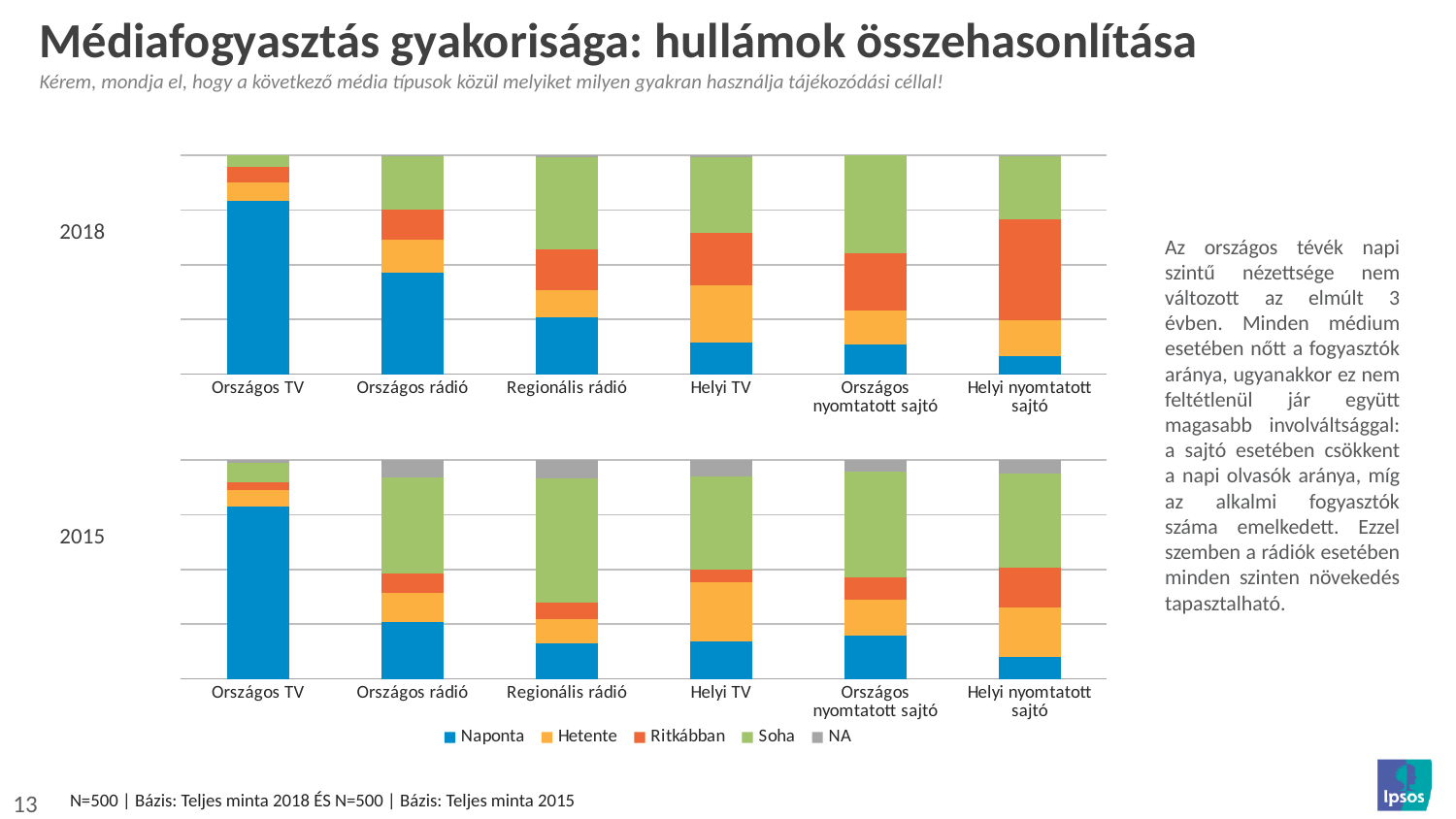
How many media categories are shown on the x axis of the 2018 chart? 6 How many series does the legend list? 5 In the 2015 chart, is the Naponta segment larger for Országos rádió or for Regionális rádió? Országos rádió In the 2018 chart, which category has the largest Naponta segment? Országos TV In the 2018 chart, which category has the largest Ritkábban segment? Helyi nyomtatott sajtó In the 2015 chart, which category has the smallest Naponta segment? Helyi nyomtatott sajtó In the 2018 chart, which category has the smallest Naponta segment? Helyi nyomtatott sajtó Which series is shown in blue in the legend? Naponta In the 2015 chart, which category has the largest Naponta segment? Országos TV In the 2018 chart, is the Naponta segment larger for Országos rádió or for Helyi TV? Országos rádió Which year's chart is positioned at the top of the slide? 2018 What kind of chart is used for the 2018 data on the slide? Stacked bar chart